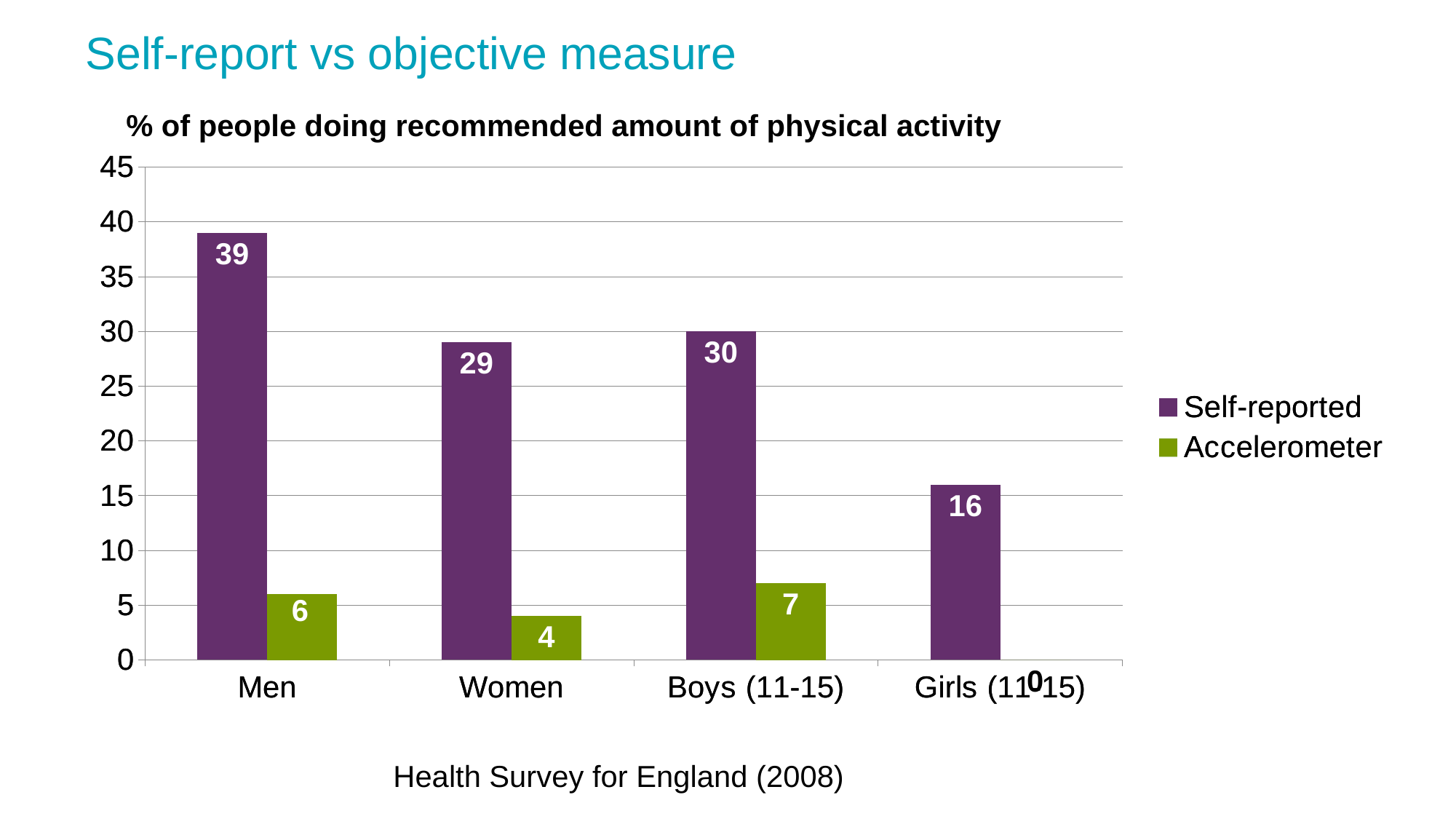
What is the title of the chart? % of people doing recommended amount of physical activity Which category has the lowest Self-reported value? Girls (11-15) How many series does the legend list? 2 How many categories are shown on the x axis? 4 What is the Accelerometer value for Boys (11-15)? 7 What is the Self-reported value for Women? 29 What is the Self-reported value for Men? 39 Which category has the highest Self-reported value? Men What is the Accelerometer value for Girls (11-15)? 0 Which is larger, the Accelerometer value for Men or for Women? Men What kind of chart is shown on the slide? Bar chart What is the difference between the Self-reported and Accelerometer values for Men? 33